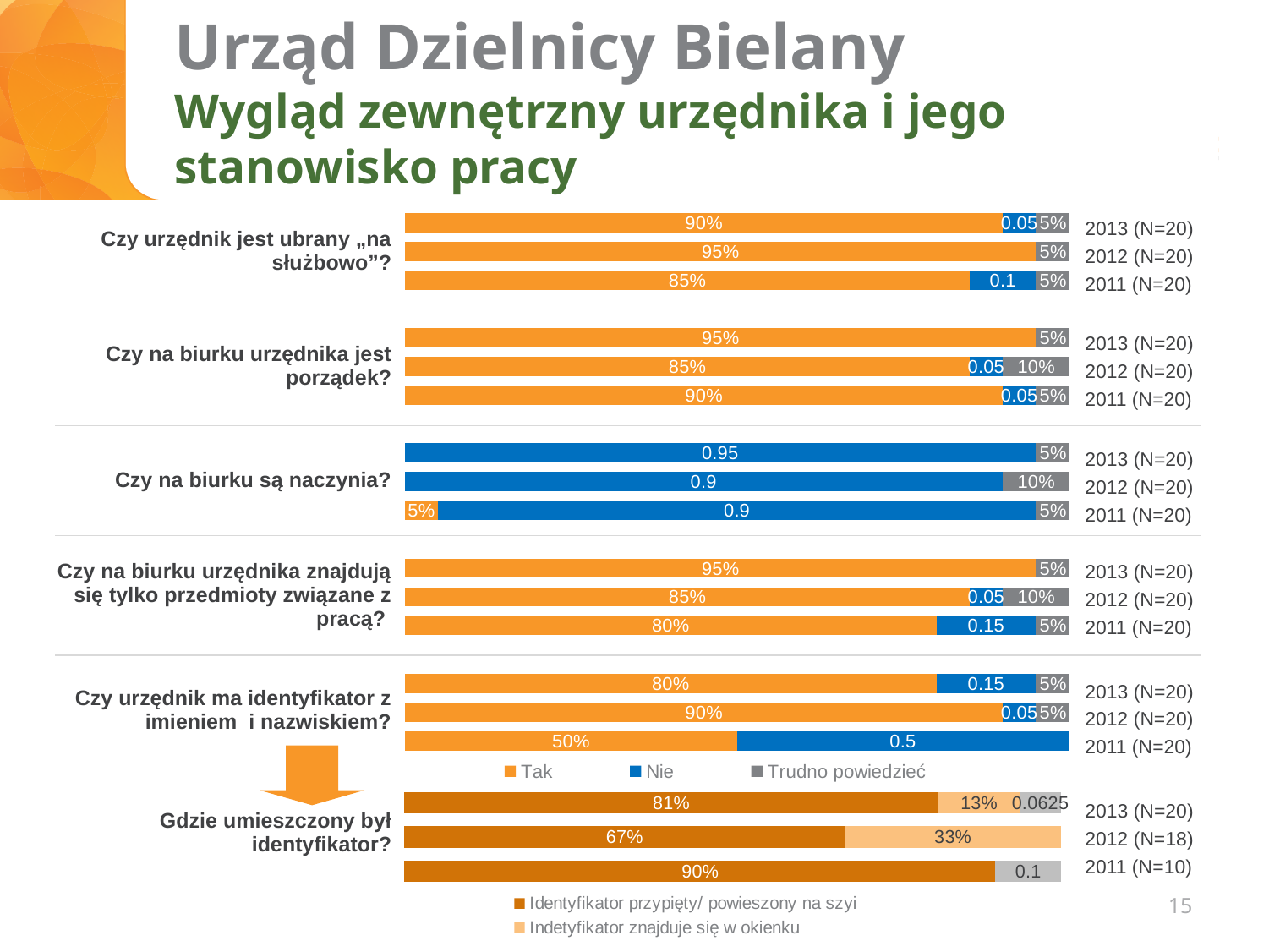
In the chart "Czy urzędnik jest ubrany „na służbowo”?", what is the "Tak" value for 2013 (N=20)? 90% In the chart "Czy na biurku są naczynia?", what is the "Tak" value for 2011 (N=20)? 5% In the chart "Czy urzędnik jest ubrany „na służbowo”?", which year has the highest "Tak" share? 2012 (N=20) In the chart "Czy na biurku są naczynia?", what is the "Nie" value for 2013 (N=20)? 0.95 In the chart "Gdzie umieszczony był identyfikator?", what is the value for "Indetyfikator znajduje się w okienku" in 2012 (N=18)? 33% In the chart "Czy na biurku urzędnika znajdują się tylko przedmioty związane z pracą?", which year has the lowest "Tak" share? 2011 (N=20) In the chart "Czy na biurku urzędnika znajdują się tylko przedmioty związane z pracą?", what is the difference between the "Tak" values for 2013 and 2011? 15% In the chart "Czy urzędnik ma identyfikator z imieniem i nazwiskiem?", is the "Tak" value larger for 2012 or 2013? 2012 What type of chart is used for "Czy na biurku są naczynia?"? Stacked bar chart In the chart "Czy na biurku urzędnika jest porządek?", what is the "Trudno powiedzieć" value for 2012 (N=20)? 10% In the chart "Gdzie umieszczony był identyfikator?", how many years (bars) are shown? 3 In the chart "Czy urzędnik ma identyfikator z imieniem i nazwiskiem?", what is the "Nie" value for 2011 (N=20)? 0.5